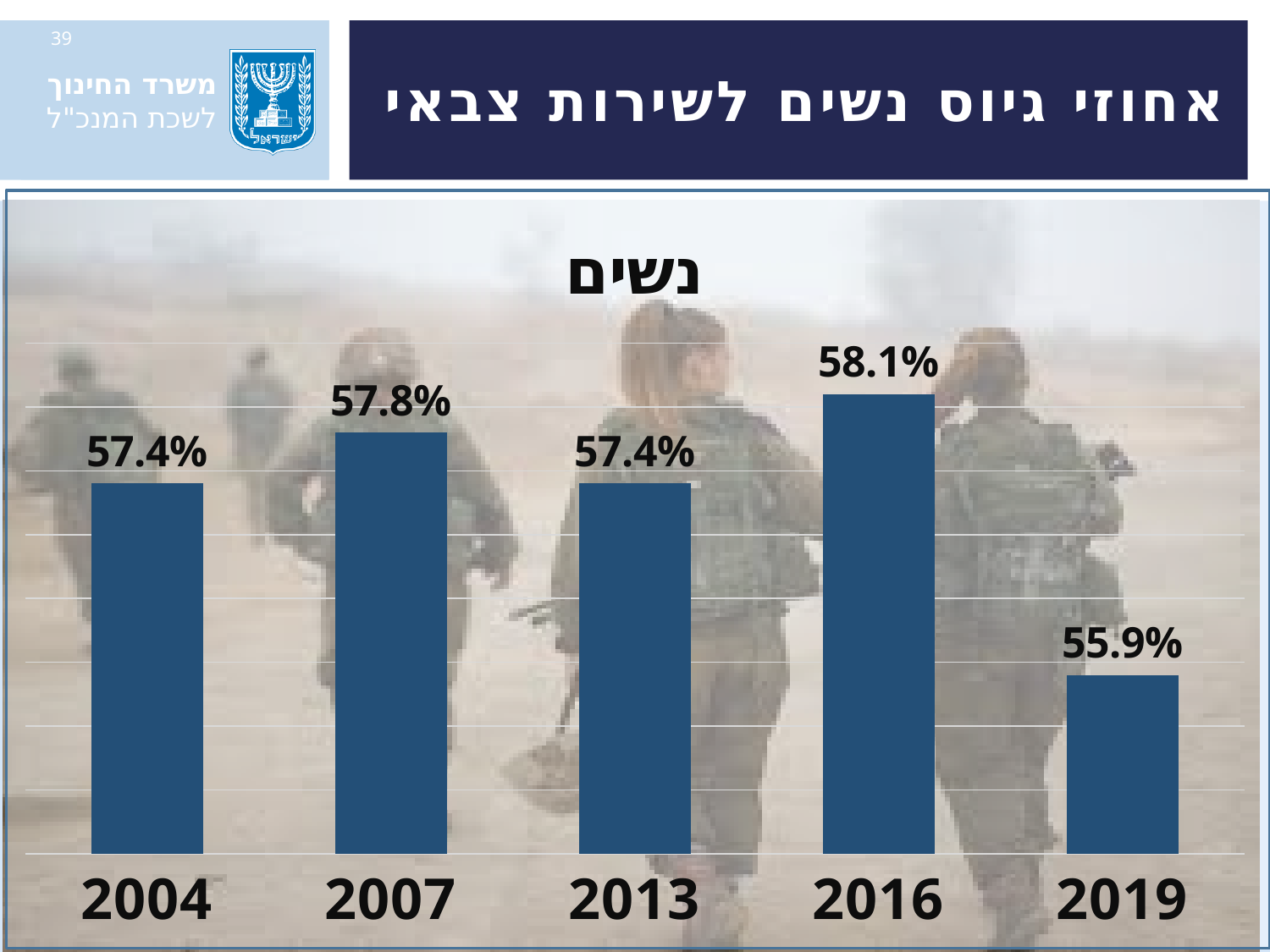
Which is larger, the value for 2007 or the value for 2019? 2007 What is the difference between the values for 2016 and 2019? 2.2% What is the difference between the values for 2007 and 2004? 0.4% What is the value for 2016? 58.1% What is the title of the chart? נשים What is the value for 2007? 57.8% How many years are shown on the chart? 5 What kind of chart is shown on the slide? Bar chart Which year has the highest value? 2016 Which year has the lowest value? 2019 What is the value for 2019? 55.9% What is the value for 2004? 57.4%